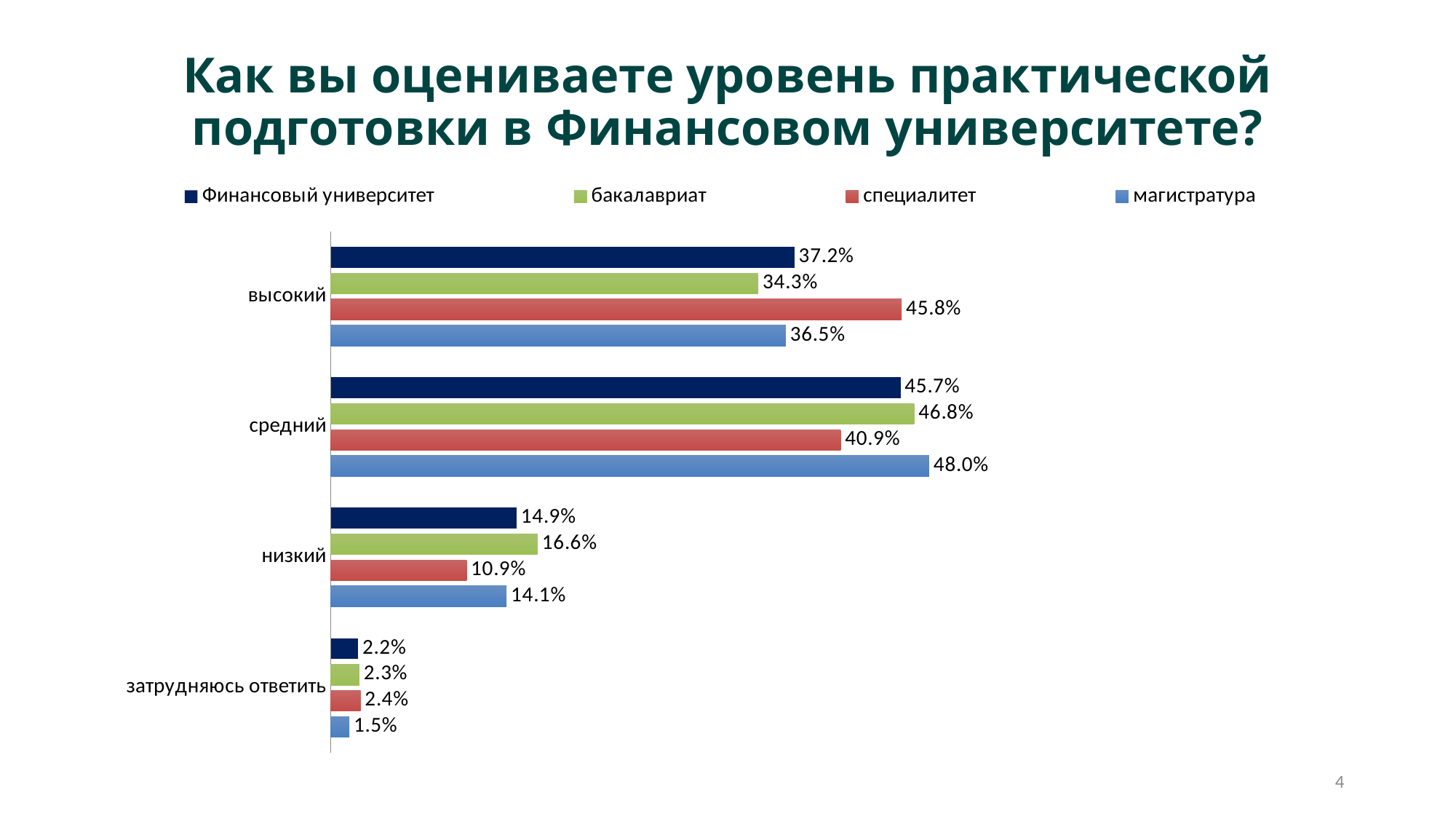
Which colour represents магистратура in the legend? light blue What is the value for специалитет in the высокий category? 45.8% What is the difference between the специалитет and бакалавриат values in the высокий category? 11.5% What is the value for магистратура in the средний category? 48.0% Which is larger in the средний category: бакалавриат or специалитет? бакалавриат How many categories are shown on the chart? 4 What is the value for Финансовый университет in the низкий category? 14.9% What kind of chart is shown on the slide? bar chart How many series does the legend list? 4 Which series has the lowest value in the низкий category? специалитет What is the value for бакалавриат in the затрудняюсь ответить category? 2.3% Which series has the highest value in the высокий category? специалитет